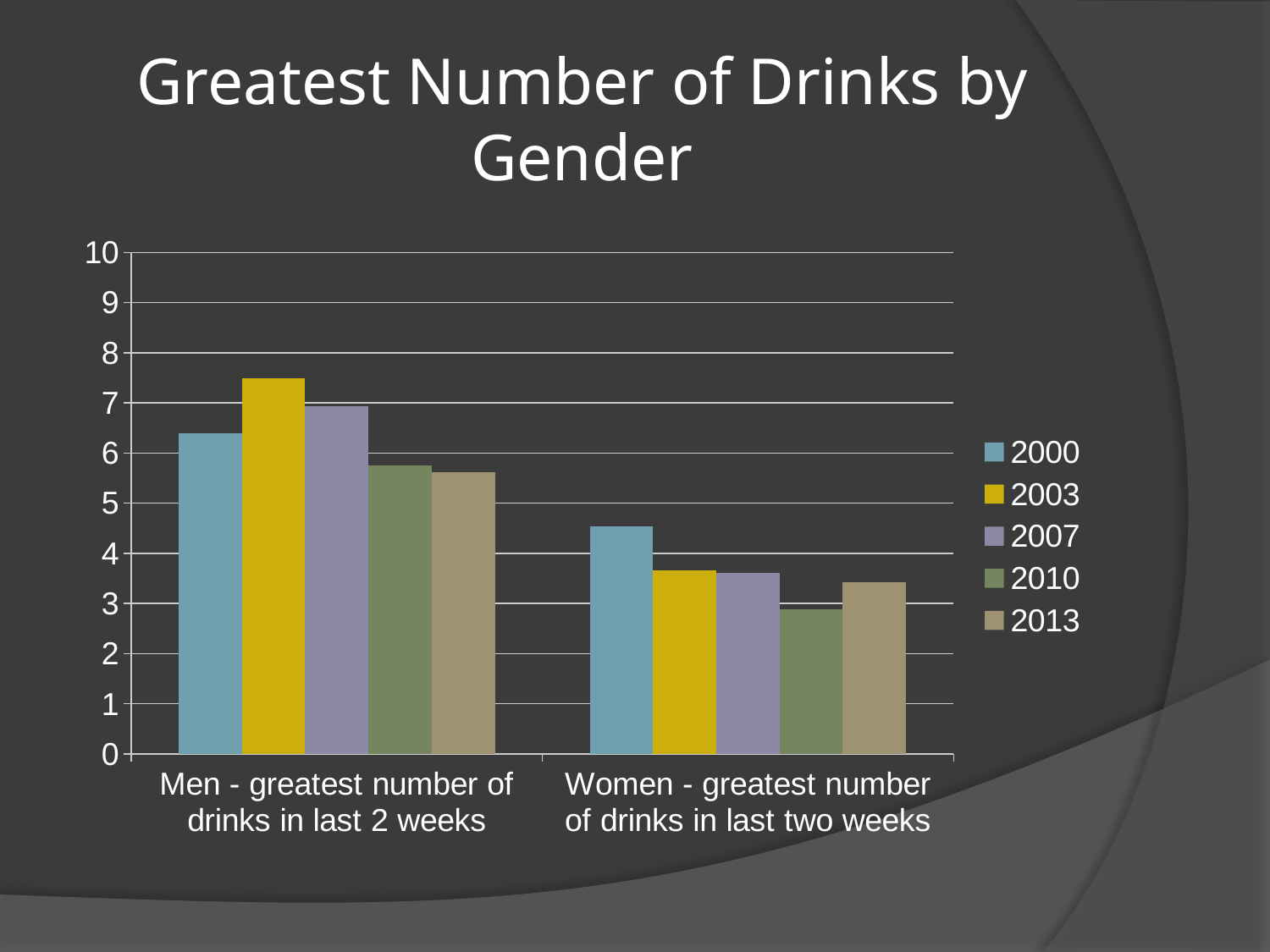
What is the title of the chart? Greatest Number of Drinks by Gender How many categories are shown on the x axis? 2 Which year has the highest value for men? 2003 Which year has the highest value for women? 2000 Which is larger, the 2000 value for men or the 2000 value for women? men Is the value for women in 2000 greater or less than 4? greater Which year has the lowest value for women? 2010 Is the value for women in 2010 greater or less than 3? less What kind of chart is shown on the slide? bar chart Is the value for men in 2010 greater or less than 6? less How many series does the legend list? 5